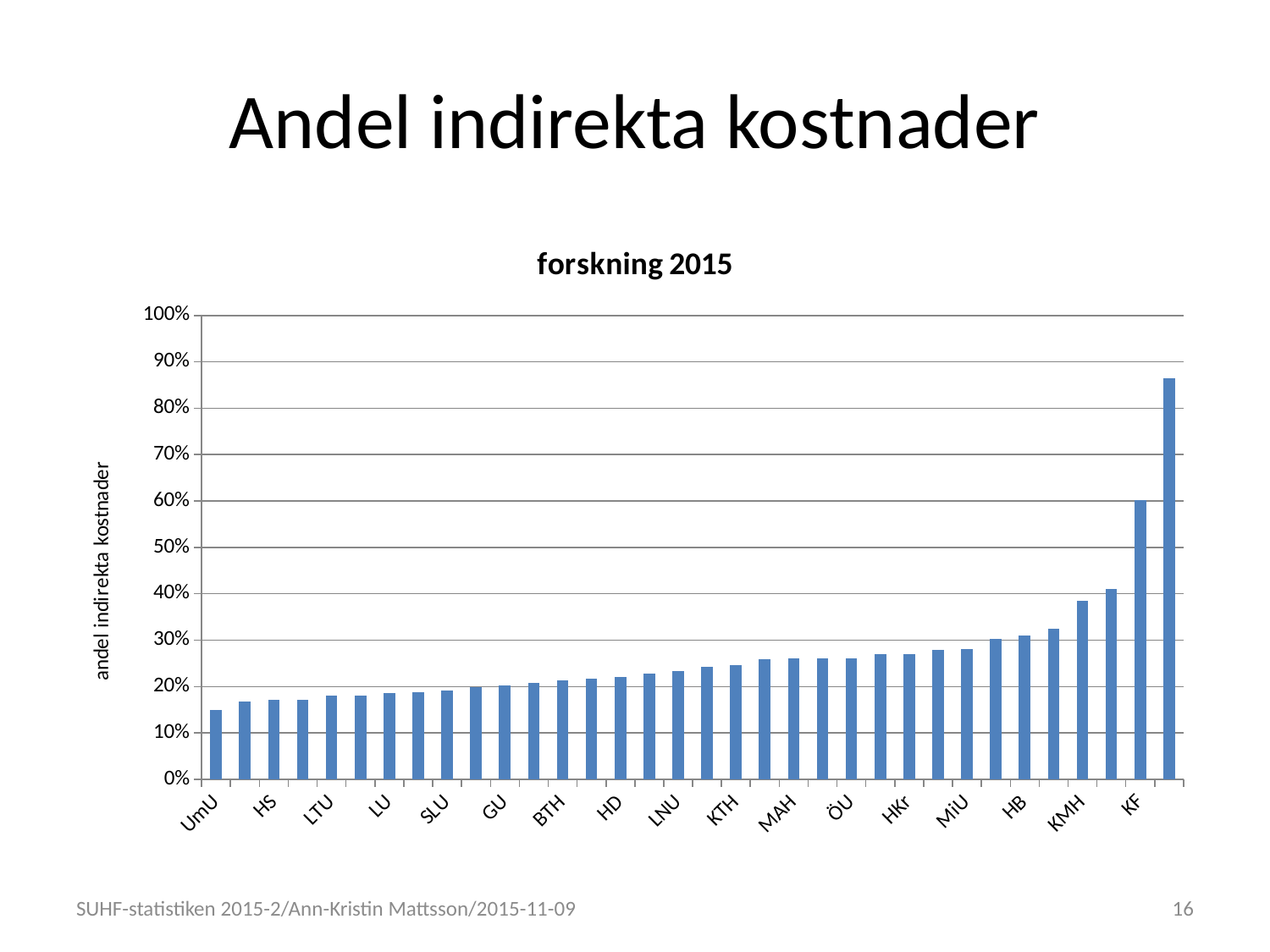
What is the title of the chart? forskning 2015 What is the label on the vertical axis of the chart? andel indirekta kostnader Which has the larger value, KF or UmU? KF What kind of chart is shown on the slide? bar chart Is the value for KF greater or less than 50%? greater Which labeled category has the lowest value? UmU Is the value for LU greater or less than 20%? less Do the bar values rise or fall from left to right along the x axis? rise Is the value for KTH greater or less than 20%? greater